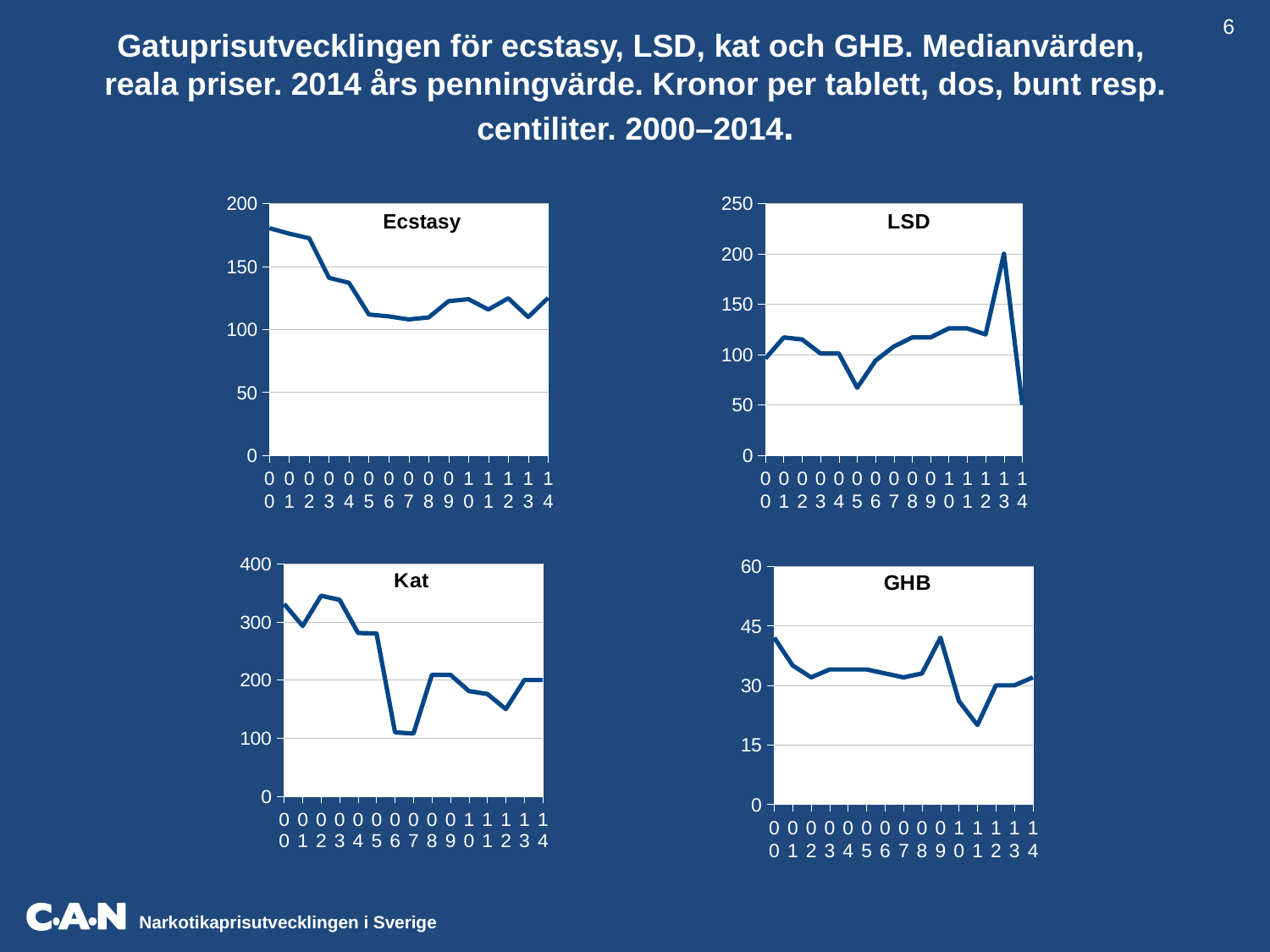
In the GHB chart, which year has the lowest value? 11 What kind of chart is the Ecstasy chart? line chart In the GHB chart, is the value for 11 greater or less than 30? less In the Ecstasy chart, is the value for 14 greater or less than 150? less In the Ecstasy chart, is the value for 00 greater or less than 150? greater In the Kat chart, do values overall rise or fall from 00 to 14? fall In the Ecstasy chart, which year has the highest value? 00 In the LSD chart, how many data points are plotted along the x axis? 15 How many charts are shown on the slide, and what are their titles? Four: Ecstasy, LSD, Kat, GHB In the LSD chart, which year has the highest value? 13